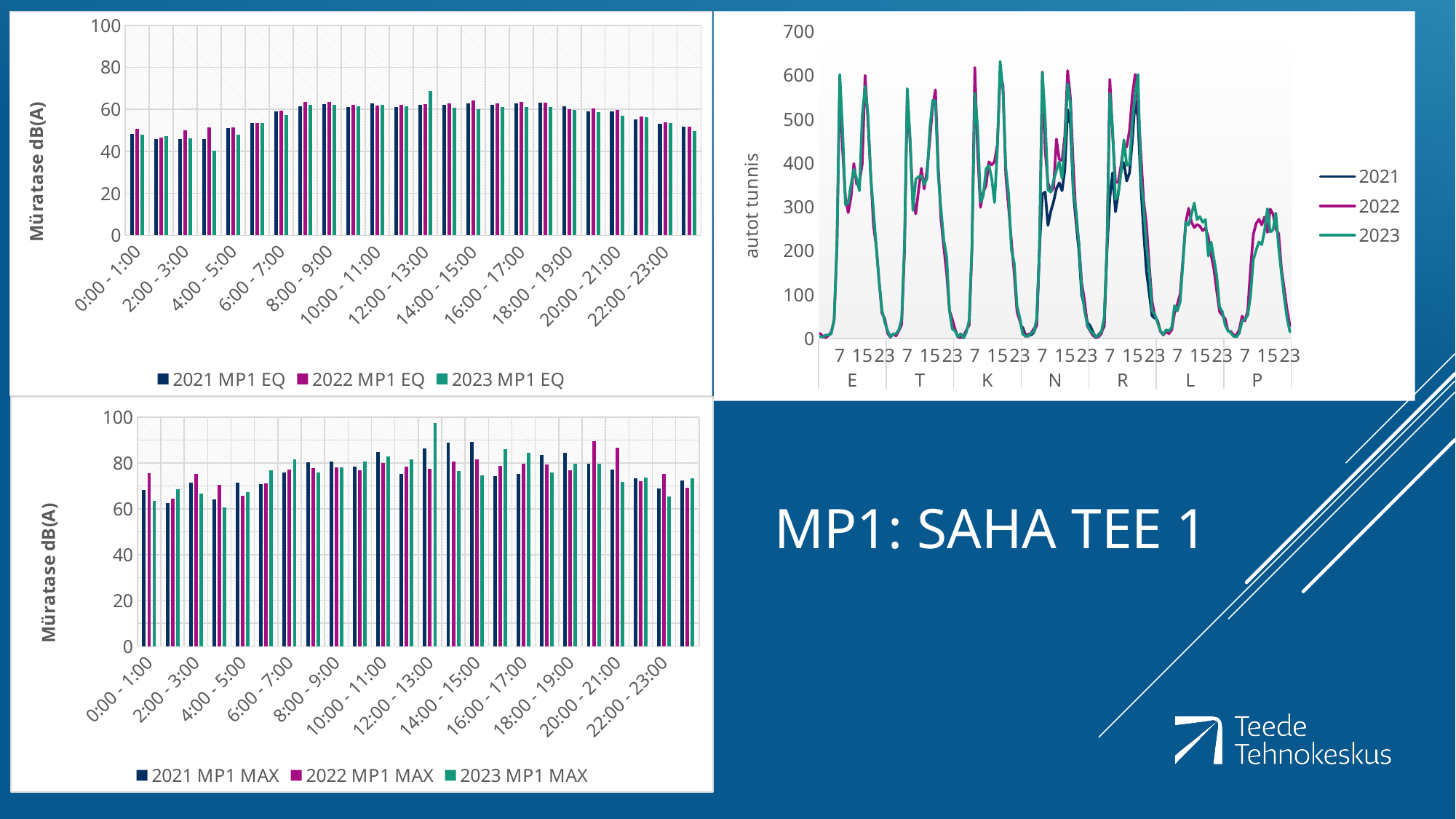
In the top-left MP1 EQ chart, do the 2021 MP1 EQ values rise or fall from 18:00 - 19:00 to 22:00 - 23:00? fall What is the y-axis label of the bottom-left MP1 MAX chart? Müratase dB(A) In the top-right 'autot tunnis' line chart, is the highest value reached on day L greater or less than 400? less How many day labels (E, T, K, ...) are shown on the x axis of the top-right 'autot tunnis' line chart? 7 What kind of chart is the top-left chart with the legend 2021 MP1 EQ, 2022 MP1 EQ, 2023 MP1 EQ? bar chart In the bottom-left MP1 MAX chart, is the value for 2021 MP1 MAX at 0:00 - 1:00 greater or less than 80? less How many series does the legend of the top-right 'autot tunnis' line chart list? 3 How many series does the legend of the top-left MP1 EQ chart list? 3 In the top-left MP1 EQ chart, is the value for 2023 MP1 EQ at 12:00 - 13:00 greater or less than 60? greater What kind of chart is the top-right chart with the y-axis labelled 'autot tunnis'? line chart